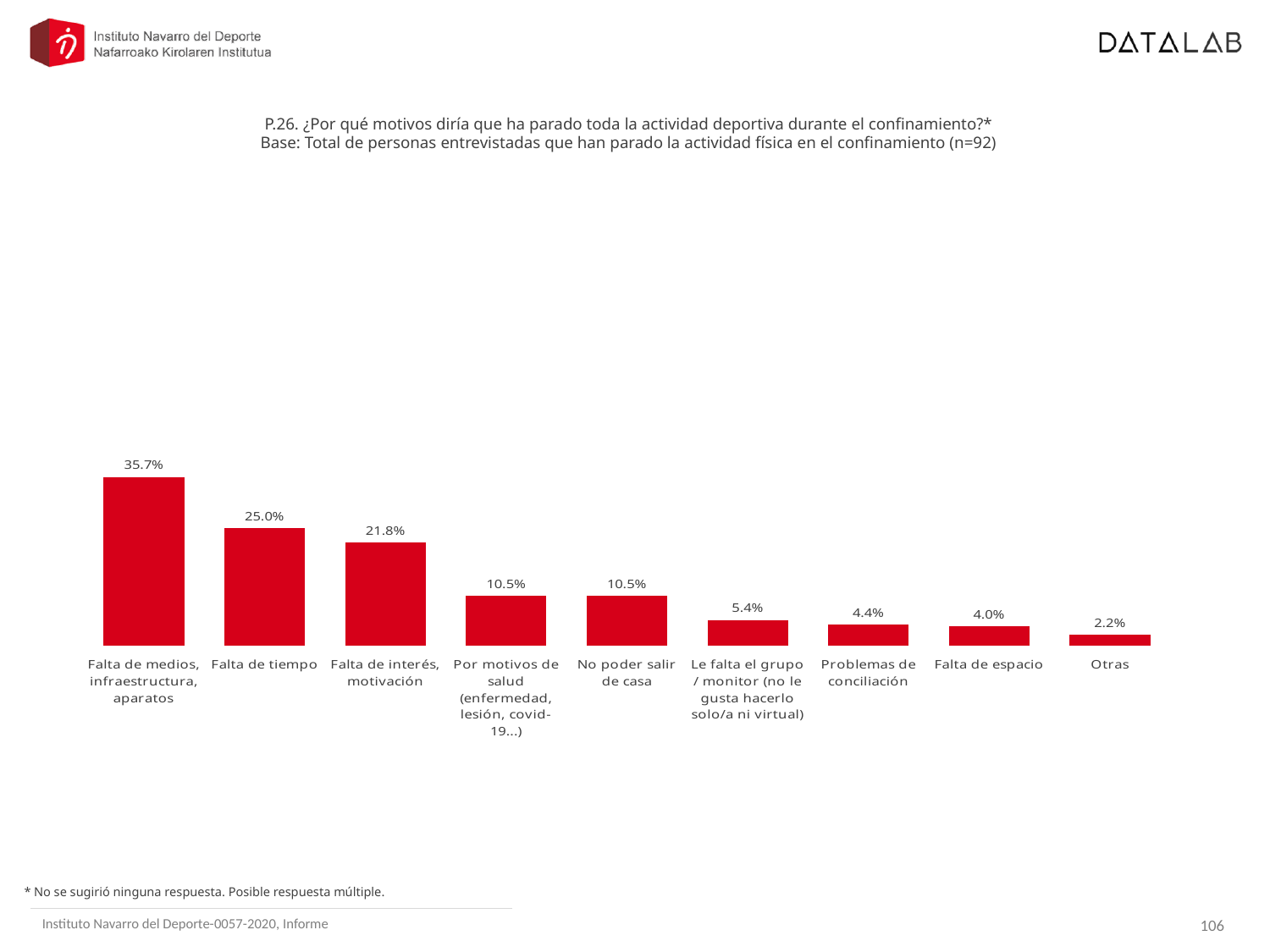
Which category has the lowest value? Otras What is the value for "Otras"? 2.2% What is the value for "Falta de interés, motivación"? 21.8% What is the difference between the values for "Falta de medios, infraestructura, aparatos" and "Falta de tiempo"? 10.7% How many categories are shown in the chart? 9 What kind of chart is shown on the slide? Bar chart Which category has the highest value? Falta de medios, infraestructura, aparatos What is the value for "Falta de tiempo"? 25.0% Which is larger, the value for "Falta de tiempo" or the value for "Falta de interés, motivación"? Falta de tiempo What is the value for "Falta de medios, infraestructura, aparatos"? 35.7% Do the values rise or fall from left to right along the x axis? Fall What is the value for "Problemas de conciliación"? 4.4%